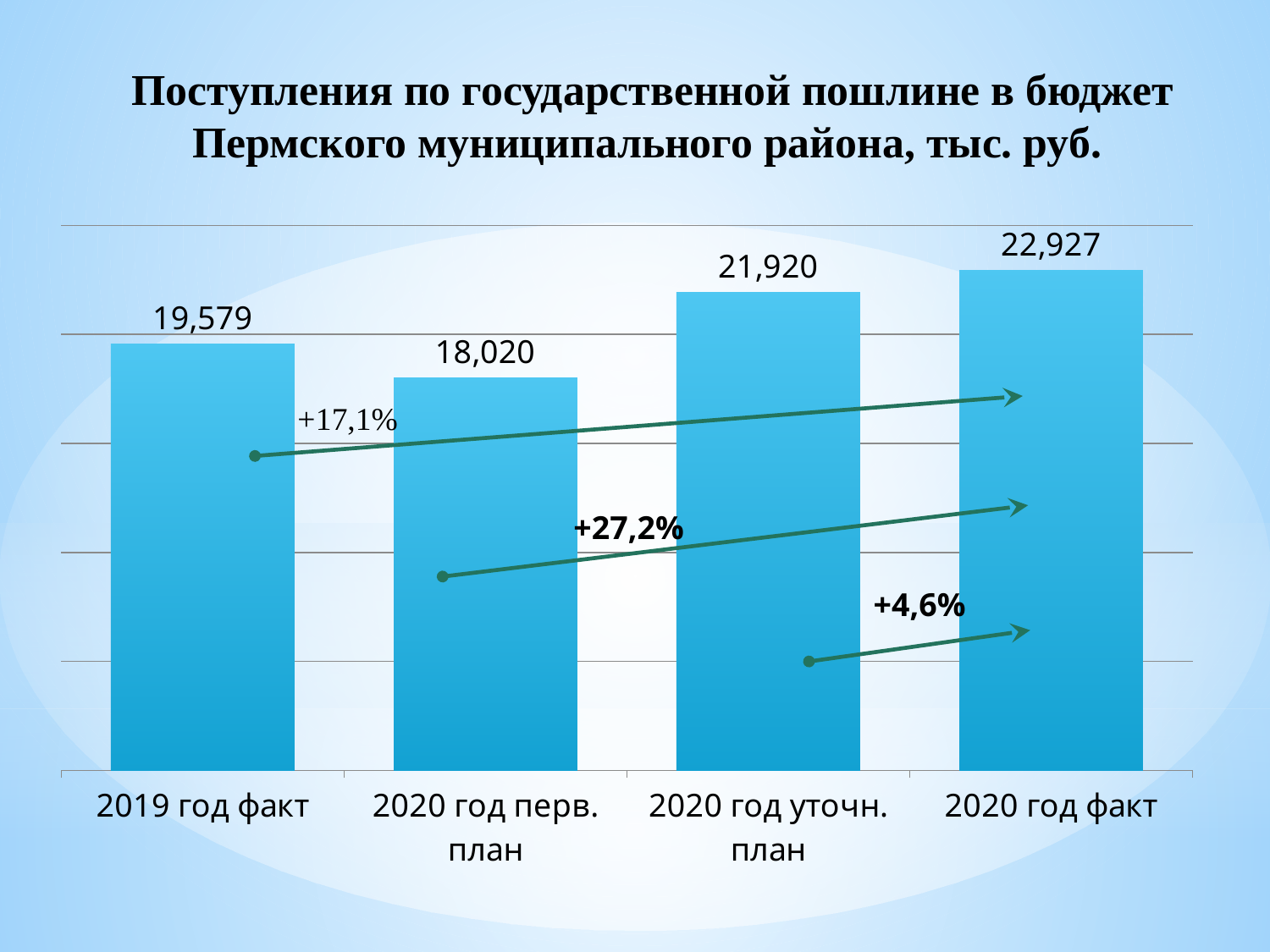
What is the difference between the values for "2020 год уточн. план" and "2020 год перв. план"? 3,900 What is the value for "2020 год уточн. план"? 21,920 How many bars are shown in the chart? 4 Which is larger, the value for "2019 год факт" or the value for "2020 год перв. план"? 2019 год факт Which category has the lowest value? 2020 год перв. план What is the value for "2019 год факт"? 19,579 Which category has the highest value? 2020 год факт What is the value for "2020 год факт"? 22,927 What is the difference between the values for "2020 год факт" and "2019 год факт"? 3,348 What percentage change is annotated on the arrow from "2020 год уточн. план" to "2020 год факт"? +4,6% What is the value for "2020 год перв. план"? 18,020 What type of chart is shown on the slide? bar chart